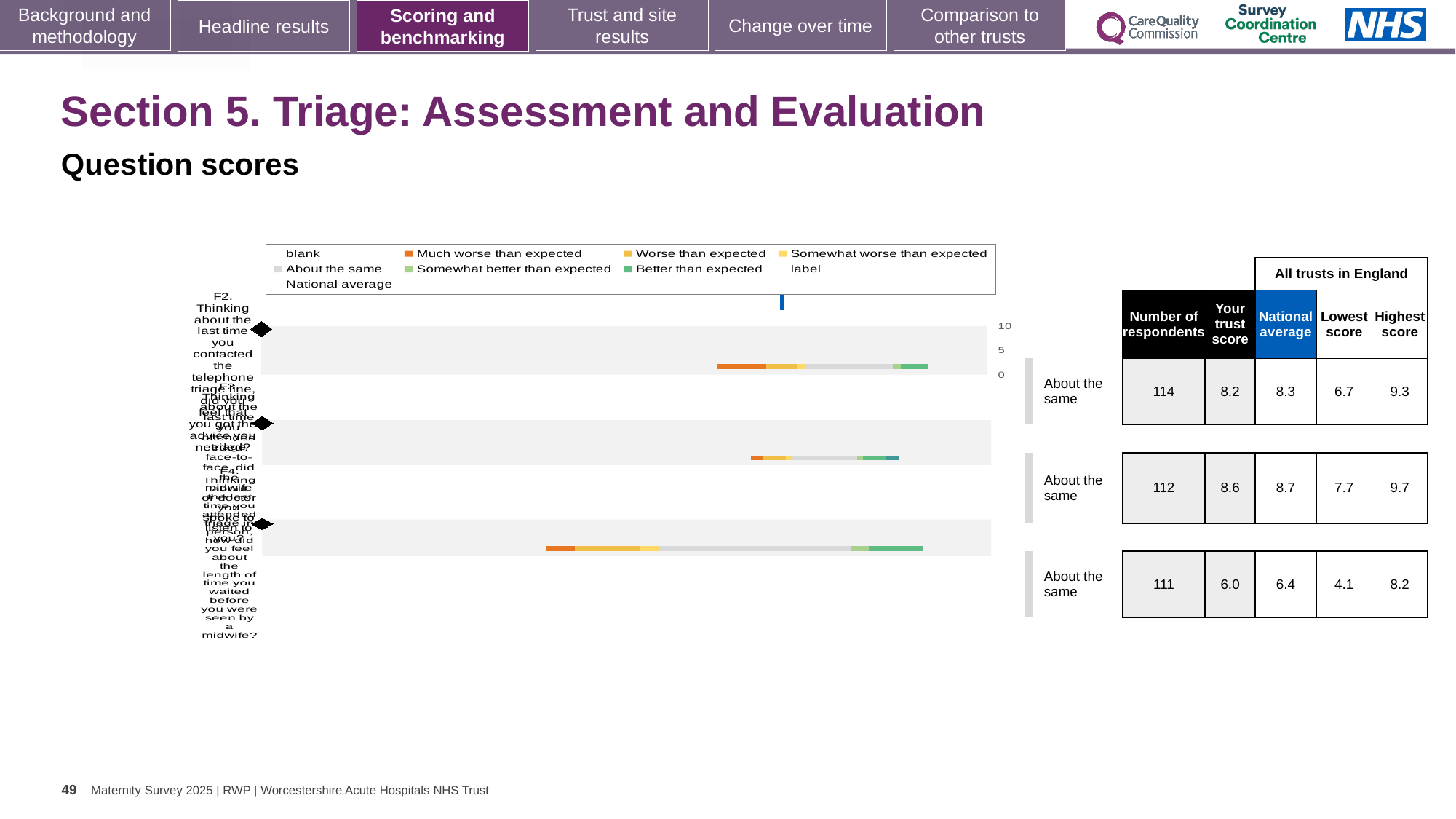
What benchmark category is shown next to each of the three question rows? About the same Which row of the table has the highest 'Your trust score'? the second row (8.6) What colour does the legend use for 'Much worse than expected'? orange In the table, what is 'Your trust score' for the third (bottom) row? 6.0 In the table, what is the number of respondents for the first (top) row? 114 In the table, what is the national average for the second row? 8.7 In the table, what is the highest score for the first (top) row? 9.3 In the first (top) row of the table, which is larger: 'Your trust score' or the national average? national average What kind of chart is used to show the question scores on this slide? bar chart Which row of the table has the lowest 'Lowest score'? the third row (4.1) How many question rows are plotted in the chart? 3 In the table, what is the difference between the national average and 'Your trust score' for the third (bottom) row? 0.4